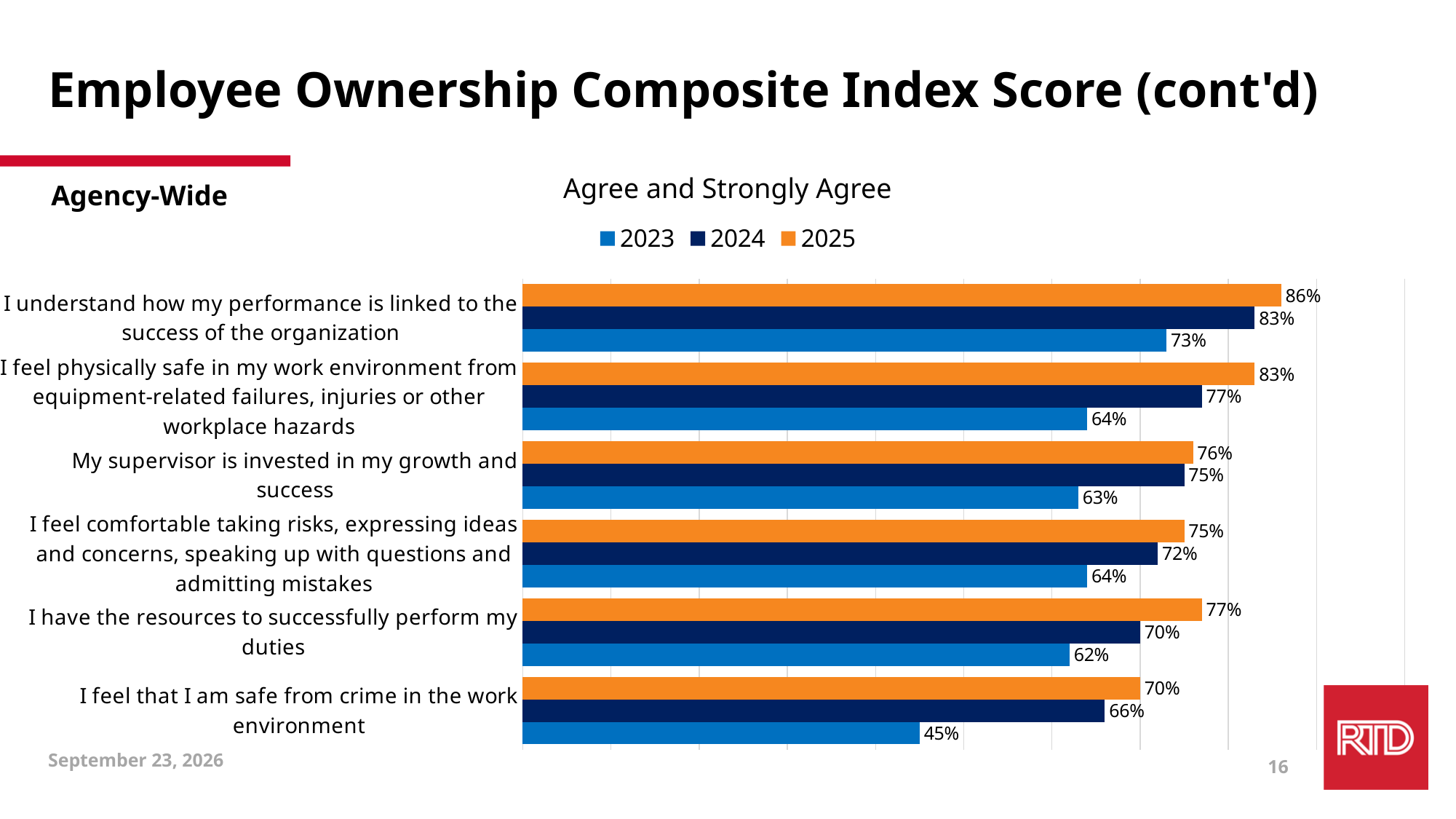
Which statement has the lowest 2023 value? I feel that I am safe from crime in the work environment How many series does the legend list? 3 What kind of chart is shown on the slide? Bar chart Which is larger for "I feel physically safe in my work environment from equipment-related failures, injuries or other workplace hazards": the 2024 value or the 2025 value? 2025 What is the difference between the 2025 and 2023 values for "I feel that I am safe from crime in the work environment"? 25% What is the title of the chart? Agree and Strongly Agree How many statements (categories) are shown in the chart? 6 Which colour represents the 2025 series in the legend? Orange What is the 2023 value for "I feel that I am safe from crime in the work environment"? 45% Which statement has the highest 2025 value? I understand how my performance is linked to the success of the organization What is the 2024 value for "I have the resources to successfully perform my duties"? 70% What is the 2025 value for "I understand how my performance is linked to the success of the organization"? 86%